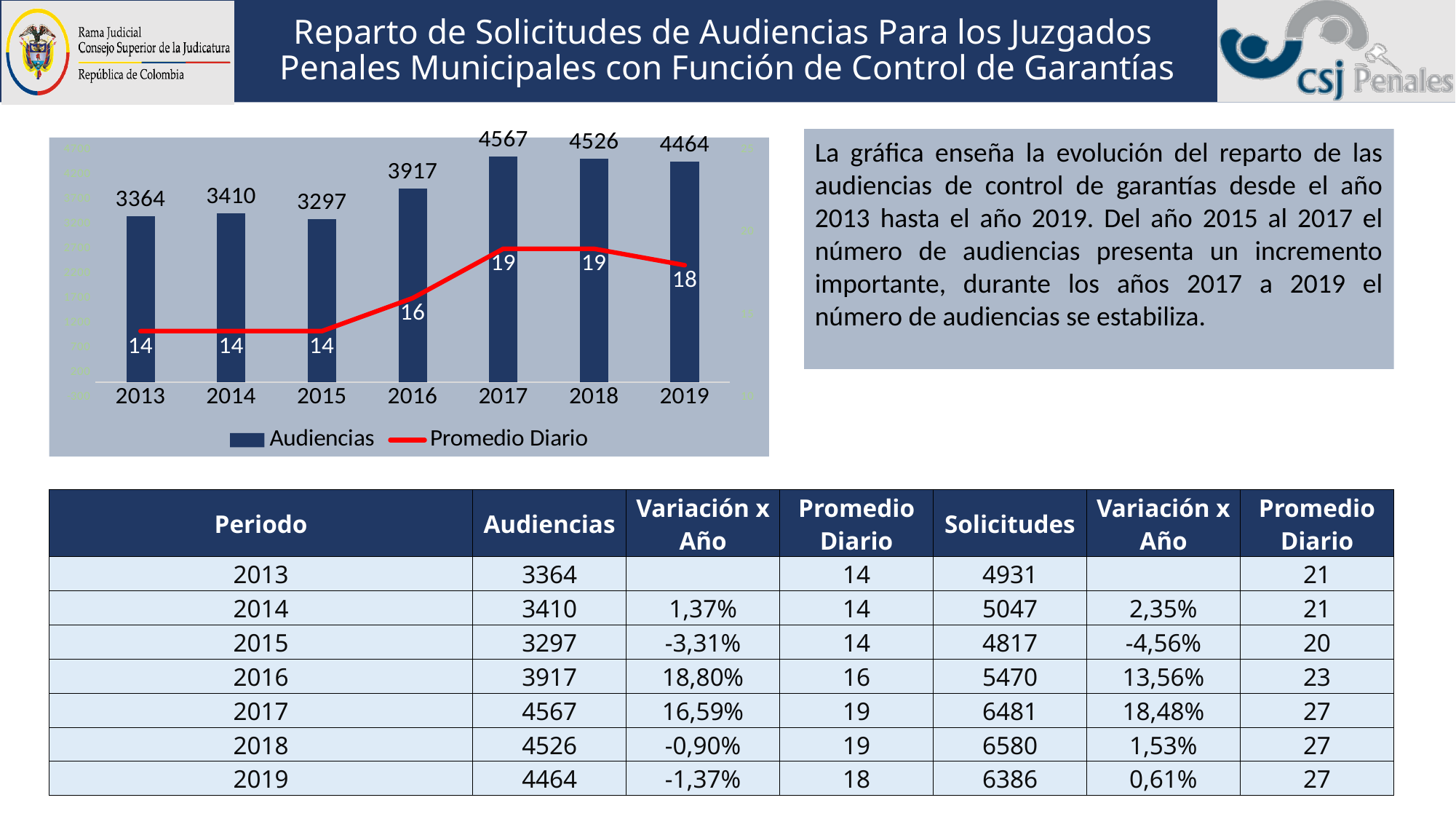
What is the Audiencias value for 2017 in the chart? 4567 What is the difference between the Audiencias values for 2017 and 2016 in the chart? 650 What kind of chart is shown on the slide? Combined bar and line chart What is the Promedio Diario value for 2016 in the chart? 16 Which is larger in the chart, the Audiencias value for 2018 or for 2019? 2018 Does the Promedio Diario line rise or fall from 2015 to 2017 in the chart? Rise Which series in the chart is drawn as a red line? Promedio Diario Which year has the lowest Audiencias value in the chart? 2015 How many years are shown on the x axis of the chart? 7 Which year has the highest Audiencias value in the chart? 2017 How many series does the chart legend list? 2 What is the Promedio Diario value for 2019 in the chart? 18